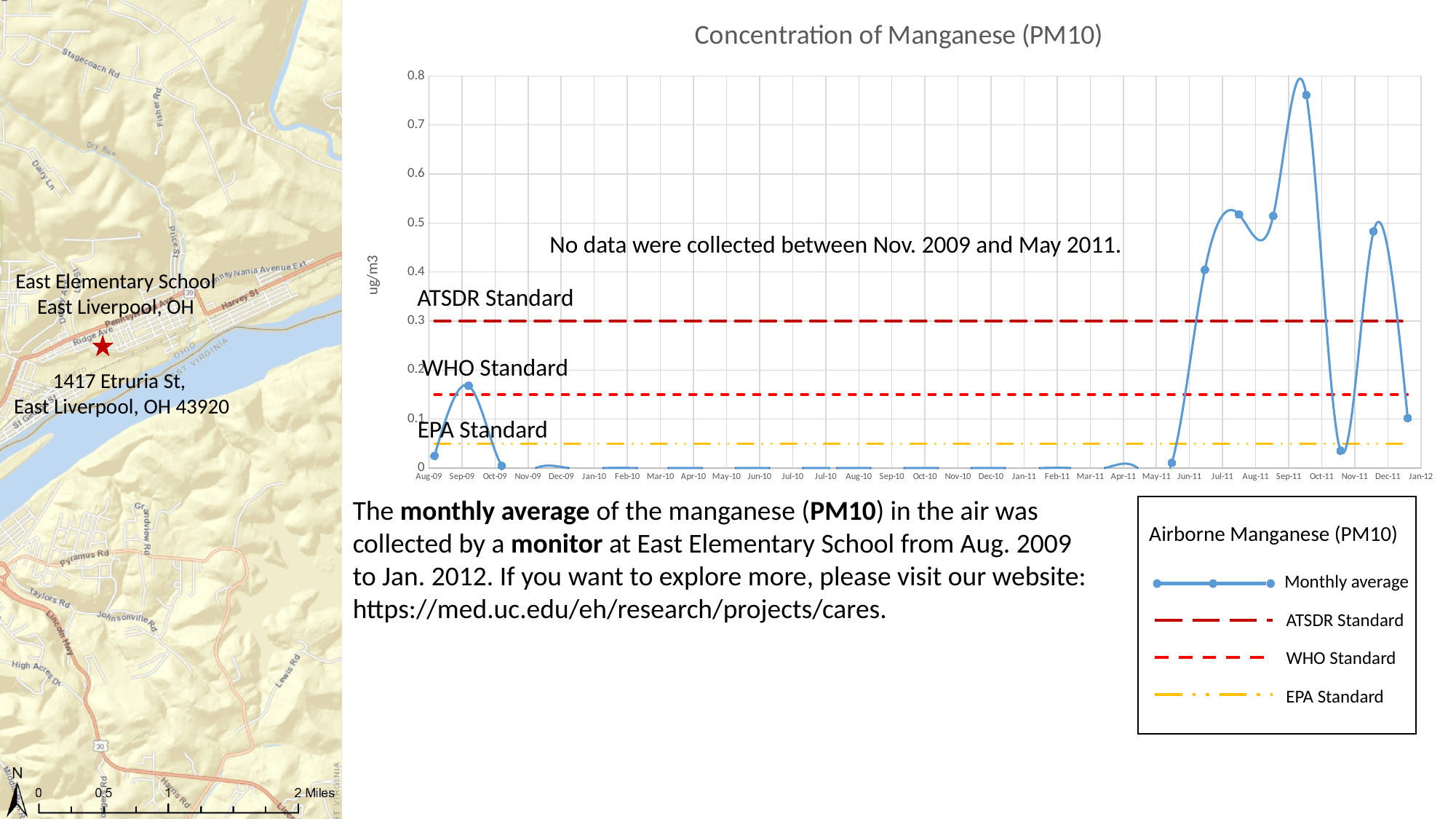
Which of the three standard lines is the highest? ATSDR Standard Is the WHO Standard greater or less than 0.2? less Which is higher, the ATSDR Standard or the WHO Standard? ATSDR Standard How many entries does the chart legend list? 4 What unit is shown on the y axis of the chart? ug/m3 What type of chart is shown on the slide? line chart Is the monthly average for Sep-09 greater or less than 0.3? less What is the title of the chart? Concentration of Manganese (PM10) Is the highest monthly average value on the chart greater or less than 0.7? greater Which of the three standard lines is the lowest? EPA Standard What value does the ATSDR Standard line sit at on the y axis? 0.3